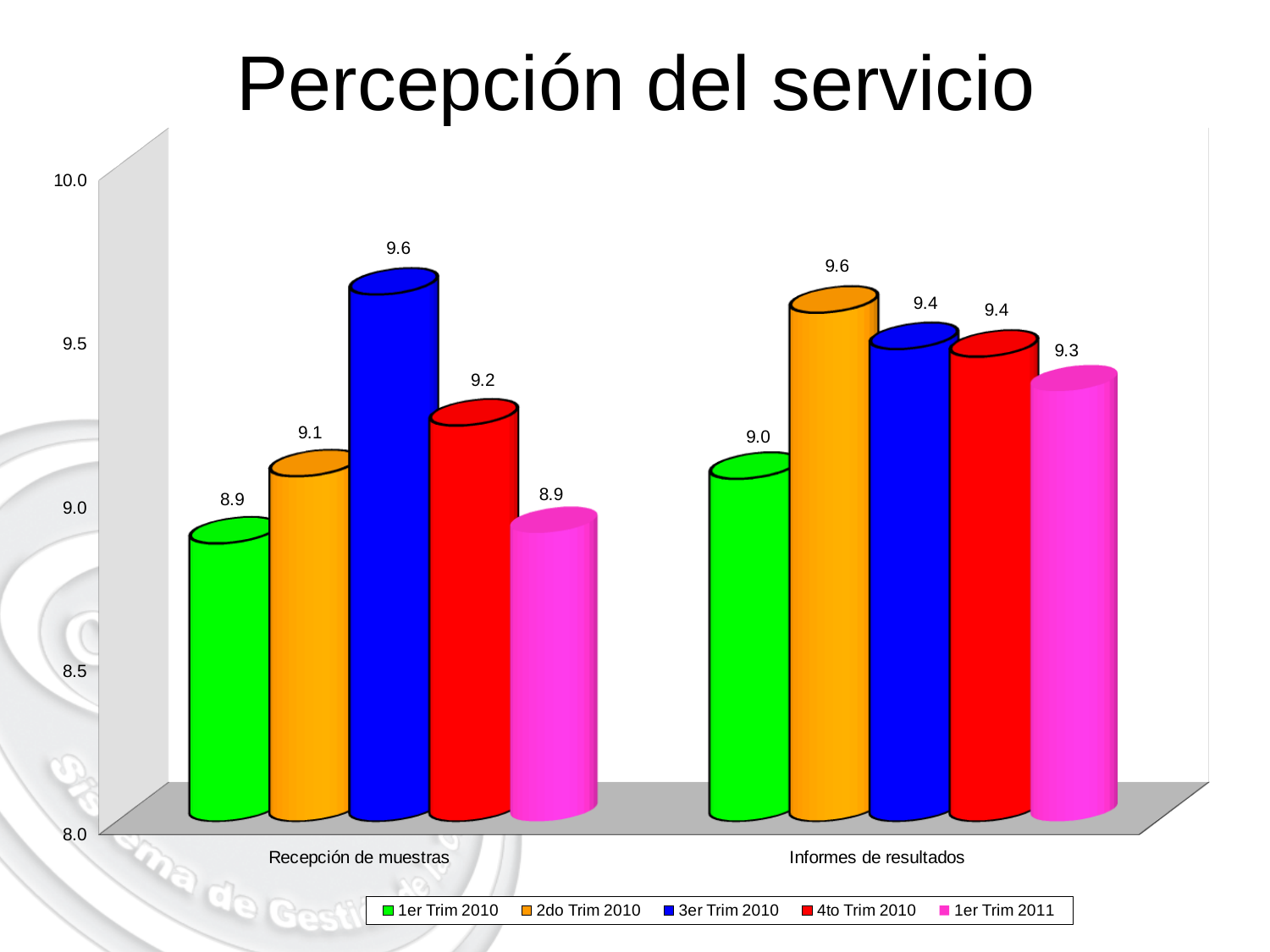
What is the value for 1er Trim 2011 in the Informes de resultados category? 9.3 What is the value for 3er Trim 2010 in the Recepción de muestras category? 9.6 What is the title of the chart? Percepción del servicio What is the value for 1er Trim 2010 in the Informes de resultados category? 9.0 How many series does the legend list? 5 Which series has the lowest value in the Informes de resultados category? 1er Trim 2010 What is the difference between the 3er Trim 2010 and 1er Trim 2010 values in the Recepción de muestras category? 0.7 Which series has the highest value in the Informes de resultados category? 2do Trim 2010 How many categories are shown on the x axis? 2 What colour represents the 1er Trim 2011 series? Pink Which is larger in the Recepción de muestras category: 4to Trim 2010 or 2do Trim 2010? 4to Trim 2010 What kind of chart is shown on the slide? Bar chart